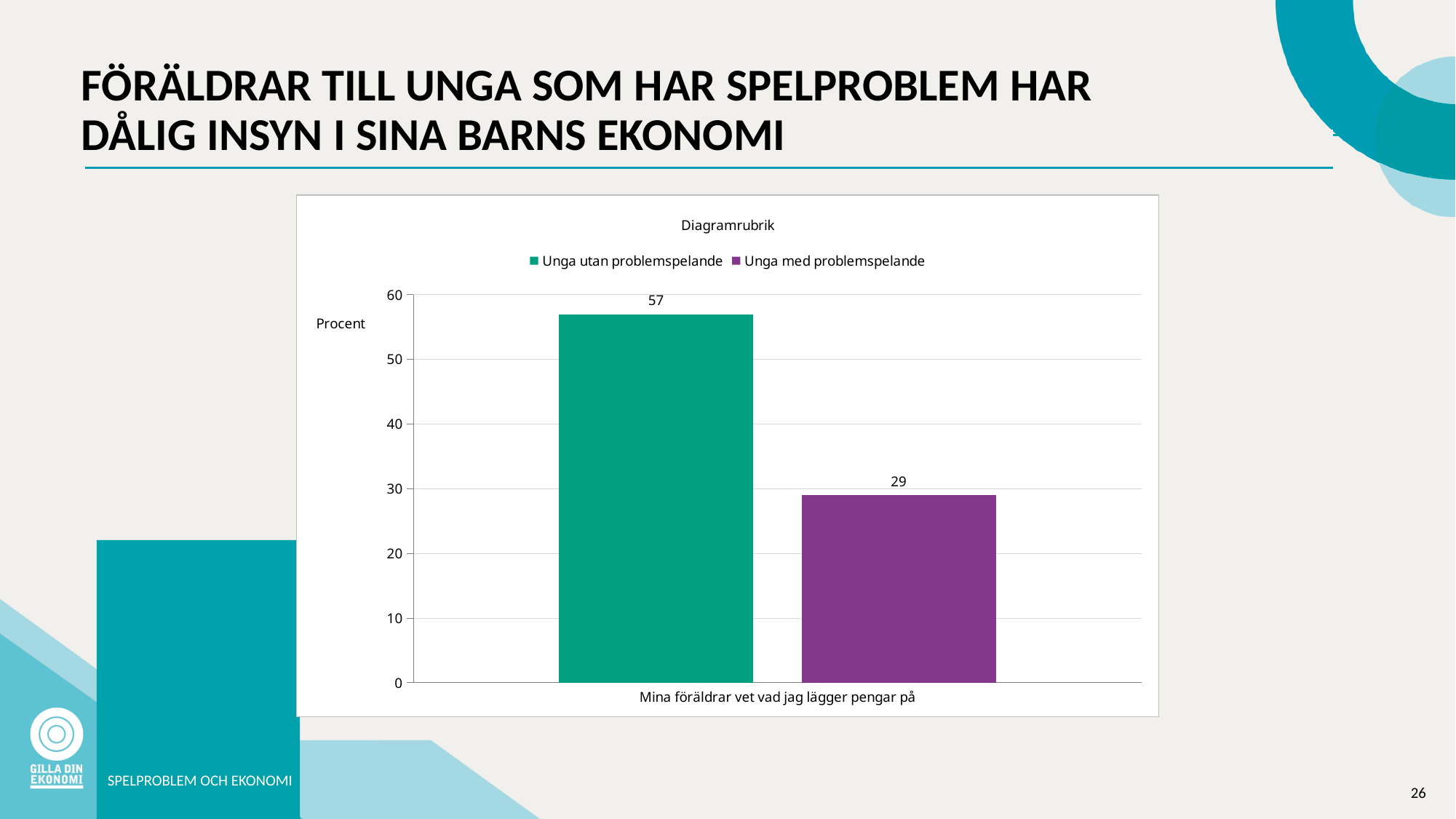
Is the value for "Unga med problemspelande" greater or less than 30? less What is the title shown above the chart? Diagramrubrik What is the value for "Unga utan problemspelande"? 57 What is the label on the vertical axis? Procent Is the value for "Unga utan problemspelande" greater or less than 50? greater Which series has the higher value? Unga utan problemspelande What is the difference between the values for "Unga utan problemspelande" and "Unga med problemspelande"? 28 How many series does the legend list? 2 What is the value for "Unga med problemspelande"? 29 What kind of chart is shown on the slide? Bar chart Which series has the lower value? Unga med problemspelande What is the category label on the x axis? Mina föräldrar vet vad jag lägger pengar på